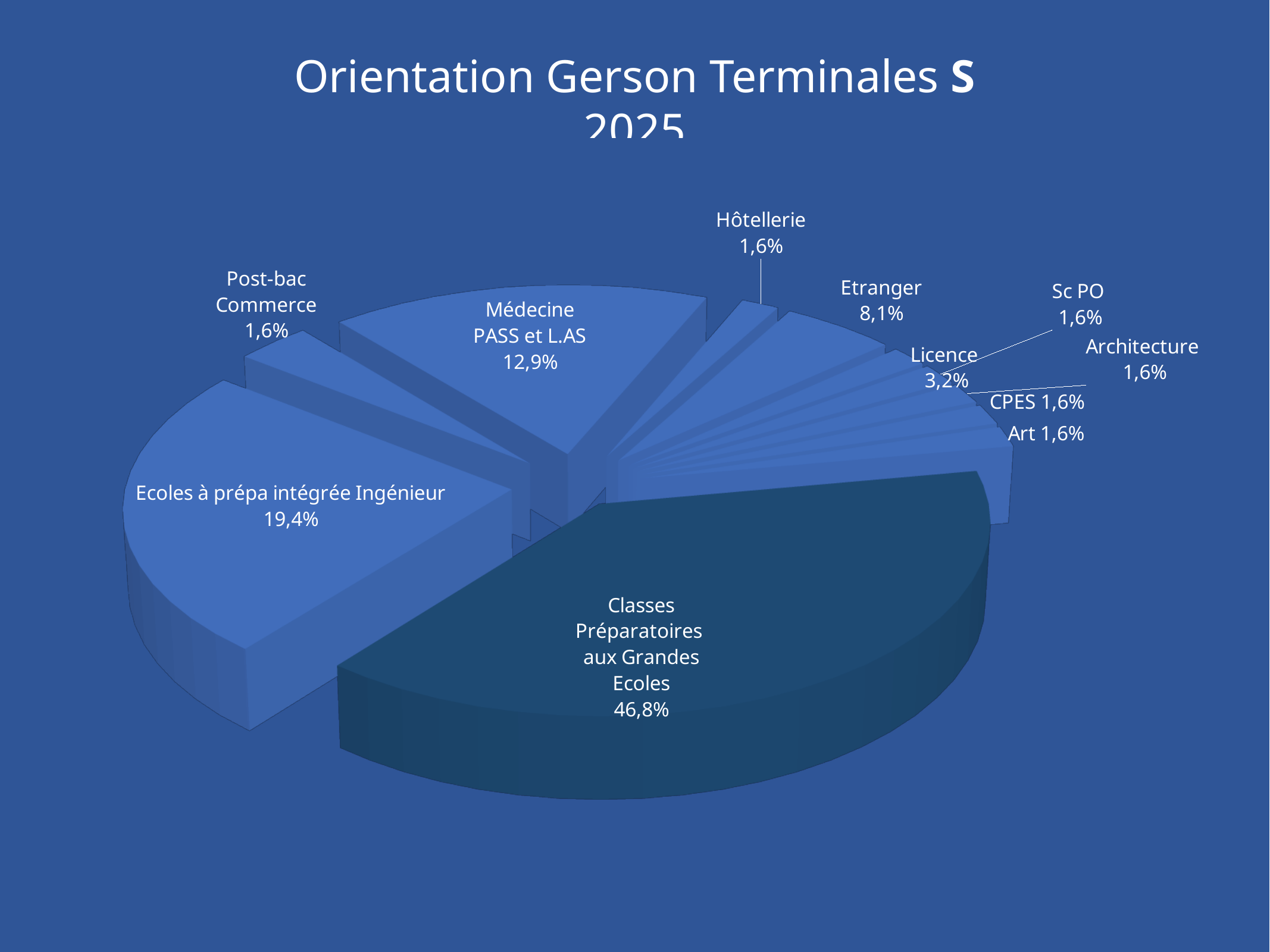
What is the value shown for Médecine PASS et L.AS? 12,9% What is the value shown for Hôtellerie? 1,6% Which category has the largest slice of the pie? Classes Préparatoires aux Grandes Ecoles What is the difference between the shares of Ecoles à prépa intégrée Ingénieur and Médecine PASS et L.AS? 6,5% What is the title of the chart on the slide? Orientation Gerson Terminales S 2025 What is the value shown for Etranger? 8,1% How many slices does the pie chart have? 11 What kind of chart is shown on the slide? Pie chart Which is larger, the share for Etranger or the share for Licence? Etranger What is the value shown for Ecoles à prépa intégrée Ingénieur? 19,4% What is the value shown for Licence? 3,2% What share of the pie is Classes Préparatoires aux Grandes Ecoles? 46,8%